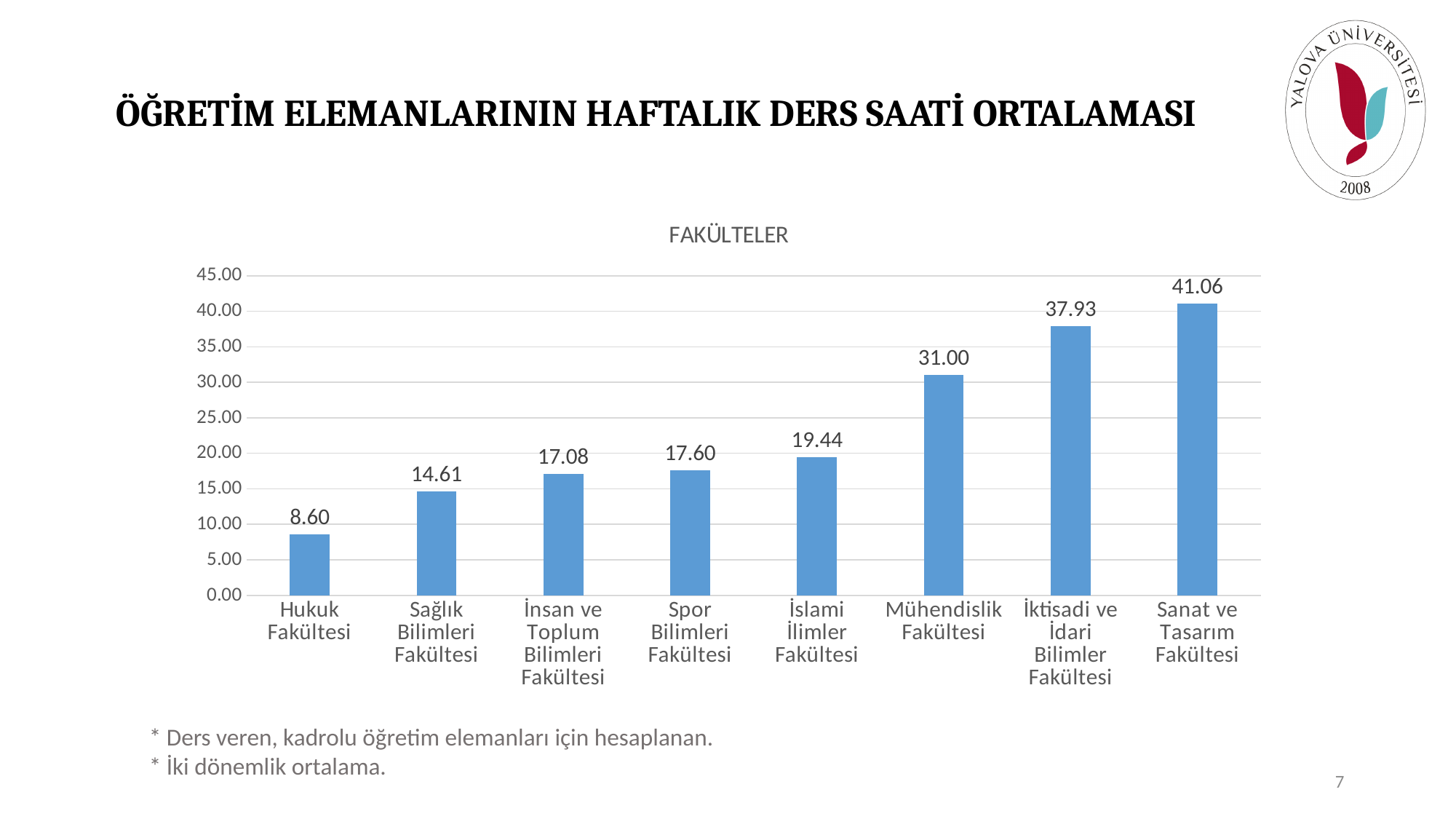
Which faculty has the lowest value? Hukuk Fakültesi Which faculty has the highest value? Sanat ve Tasarım Fakültesi Which is larger, the value for Spor Bilimleri Fakültesi or the value for Sağlık Bilimleri Fakültesi? Spor Bilimleri Fakültesi Do the values rise or fall from left to right along the x axis? rise How many faculties are shown on the chart? 8 What kind of chart is shown on the slide? bar chart What is the value for Mühendislik Fakültesi? 31.00 Is the value for İktisadi ve İdari Bilimler Fakültesi greater or less than 35.00? greater What is the difference between the values for Sanat ve Tasarım Fakültesi and İktisadi ve İdari Bilimler Fakültesi? 3.13 What is the value for İslami İlimler Fakültesi? 19.44 What is the difference between the values for Mühendislik Fakültesi and Hukuk Fakültesi? 22.40 What is the value for Hukuk Fakültesi? 8.60